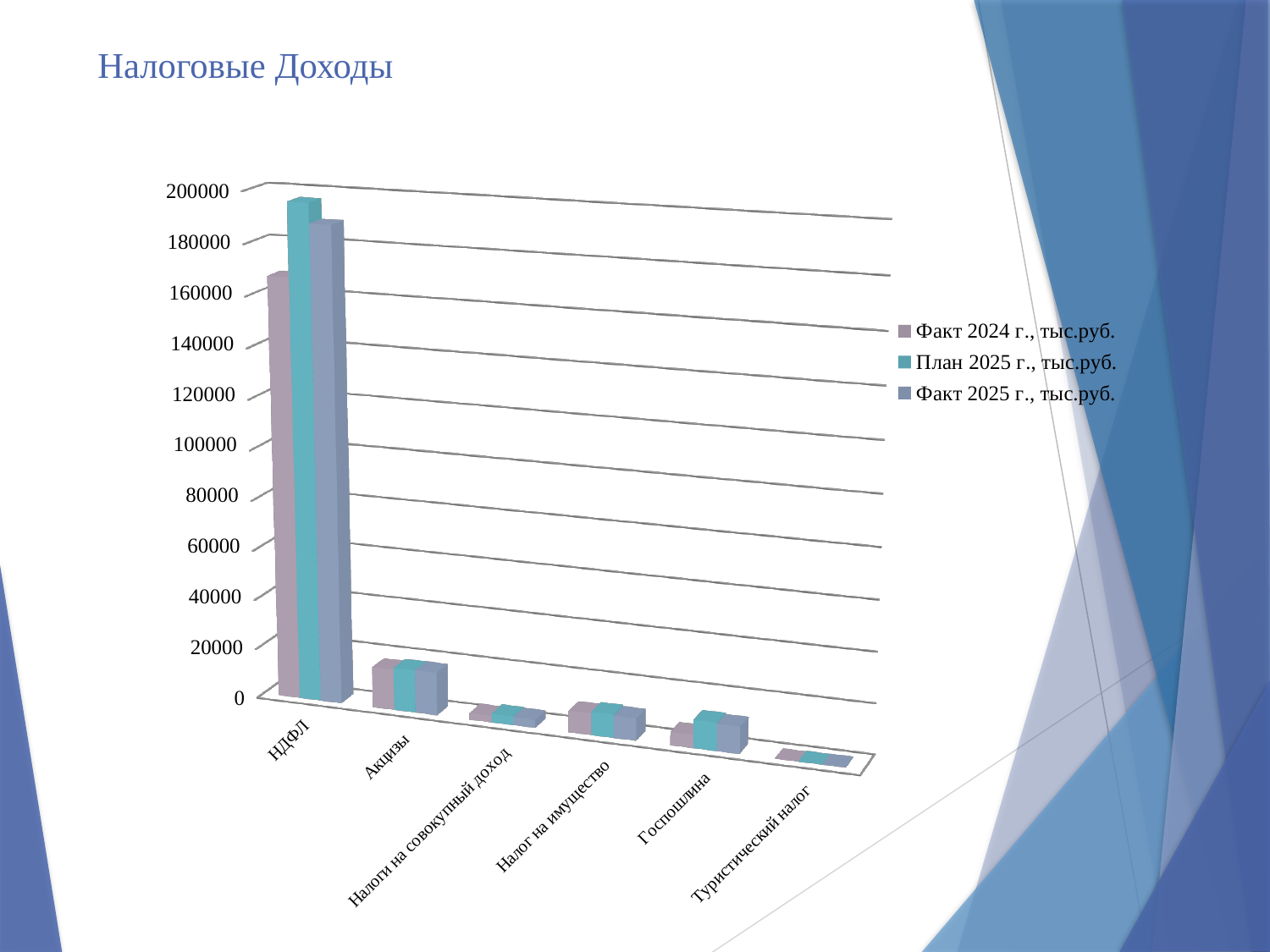
What kind of chart is shown on the slide? bar chart Which legend entry is shown in teal (green-blue) colour? План 2025 г., тыс.руб. Which category has the lowest values in the chart? Туристический налог Which category has the highest values in the chart? НДФЛ How many categories are shown on the x axis of the chart? 6 What is the title of the slide with the chart? Налоговые Доходы For Госпошлина, which is larger: the value for План 2025 г., тыс.руб. or the value for Факт 2024 г., тыс.руб.? План 2025 г., тыс.руб. How many series does the chart legend list? 3 Is the value for Акцизы in the series Факт 2024 г., тыс.руб. greater or less than 40000? less For НДФЛ, which is larger: the value for План 2025 г., тыс.руб. or the value for Факт 2024 г., тыс.руб.? План 2025 г., тыс.руб. Is the value for НДФЛ in the series План 2025 г., тыс.руб. greater or less than 160000? greater Is the value for НДФЛ in the series Факт 2024 г., тыс.руб. greater or less than 140000? greater